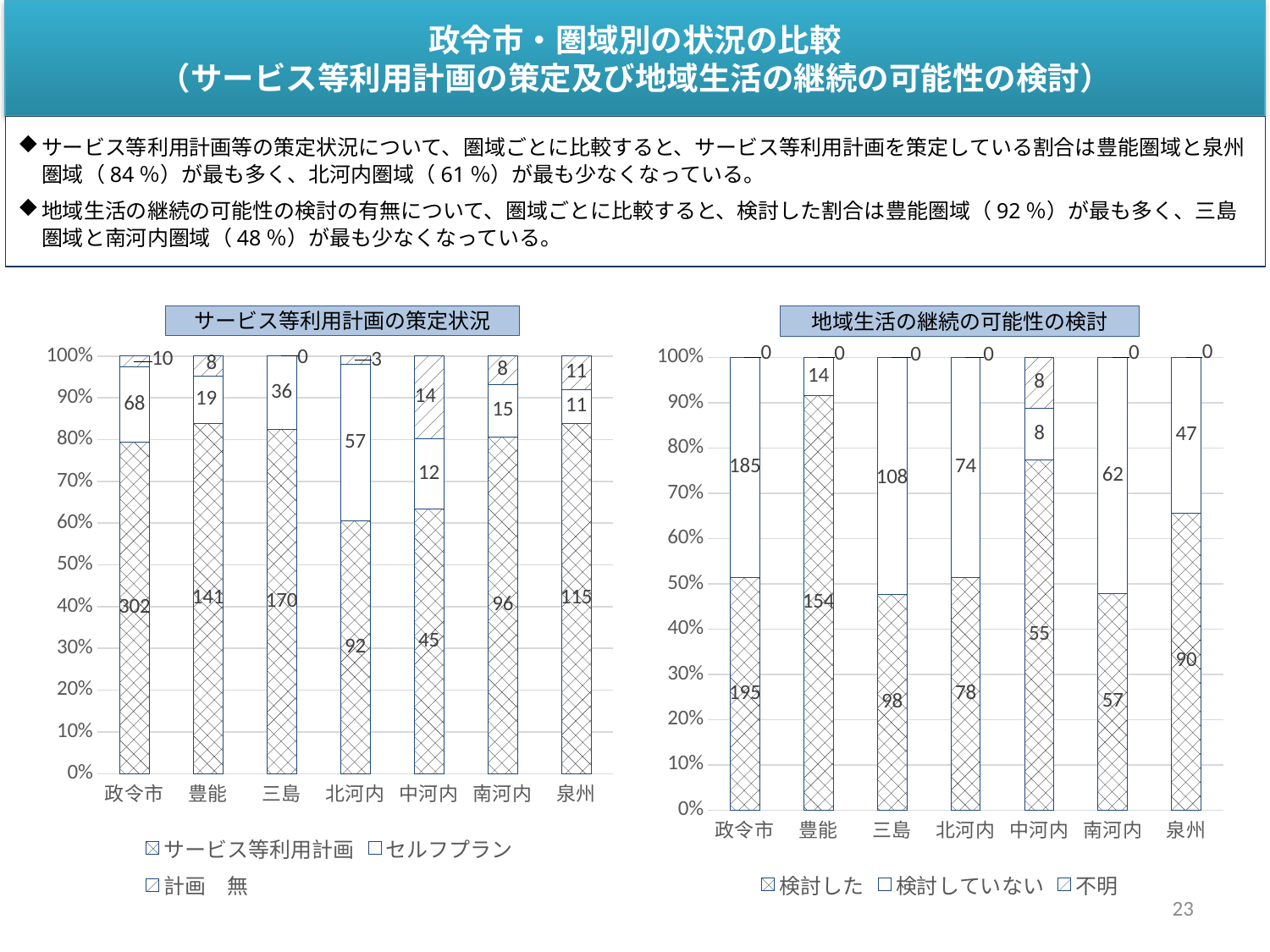
In the chart titled 地域生活の継続の可能性の検討, what is the value of 検討した for 泉州? 90 In the chart titled サービス等利用計画の策定状況, how many series does the legend list? 3 In the chart titled 地域生活の継続の可能性の検討, is the value of 検討した for 南河内 larger or smaller than the value of 検討していない for 南河内? smaller In the chart titled サービス等利用計画の策定状況, what is the value of サービス等利用計画 for 政令市? 302 In the chart titled 地域生活の継続の可能性の検討, which category has the lowest value for 検討した? 中河内 In the chart titled サービス等利用計画の策定状況, what is the total of the stacked bar for 豊能? 168 In the chart titled 地域生活の継続の可能性の検討, what is the difference between 検討した and 検討していない for 豊能? 140 In the chart titled サービス等利用計画の策定状況, what is the value of セルフプラン for 北河内? 57 What kind of chart is the chart titled サービス等利用計画の策定状況? stacked bar chart In the chart titled サービス等利用計画の策定状況, which category has the highest value for サービス等利用計画? 政令市 In the chart titled 地域生活の継続の可能性の検討, how many categories are shown on the x axis? 7 In the chart titled 地域生活の継続の可能性の検討, what is the value of 検討していない for 三島? 108